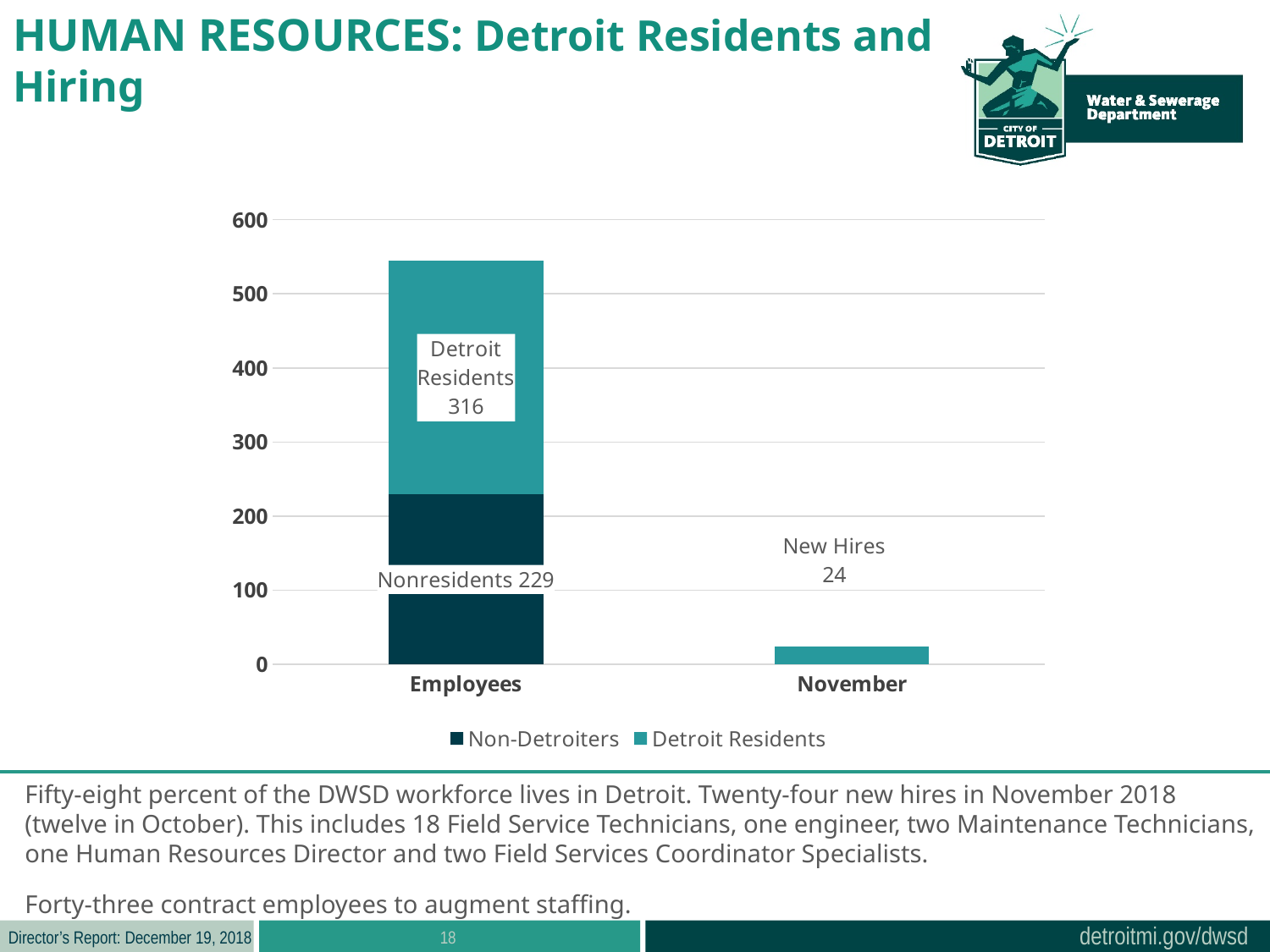
How many Detroit Residents are shown in the Employees bar? 316 What is the difference between the Detroit Residents value and the Nonresidents value in the Employees bar? 87 Is the total Employees bar greater or less than 500? greater Which is larger in the Employees bar, Detroit Residents or Nonresidents? Detroit Residents What is the value labelled New Hires for November? 24 What are the two entries in the chart legend? Non-Detroiters and Detroit Residents How many series does the legend list? 2 What kind of chart is shown on the slide? Stacked bar chart How many categories are shown on the x axis? 2 What is the total height of the stacked Employees bar? 545 Which category has the lower total bar height, Employees or November? November How many Nonresidents are shown in the Employees bar? 229